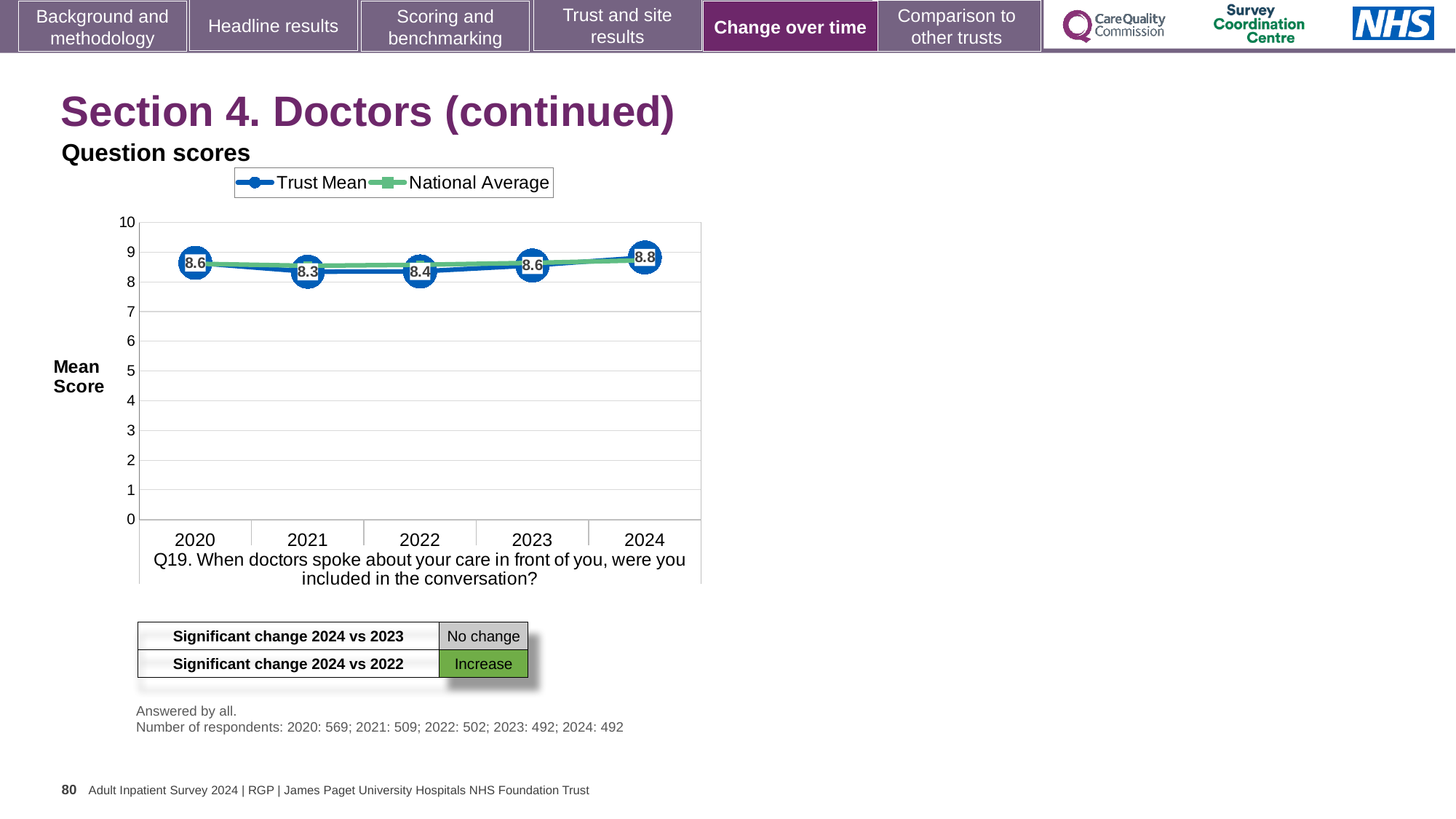
Is the National Average value for 2021 greater or less than 8? greater In which year is the Trust Mean score highest? 2024 What kind of chart is shown on the slide? Line chart Does the Trust Mean score rise or fall from 2021 to 2024? Rise What is the Trust Mean score for 2020? 8.6 How many years are shown on the x axis of the chart? 5 What is the difference between the Trust Mean score in 2024 and in 2021? 0.5 What is the Trust Mean score for 2021? 8.3 In which year is the Trust Mean score lowest? 2021 How many series does the chart legend list? 2 What is the Trust Mean score for 2024? 8.8 Which year has the larger Trust Mean score, 2022 or 2023? 2023